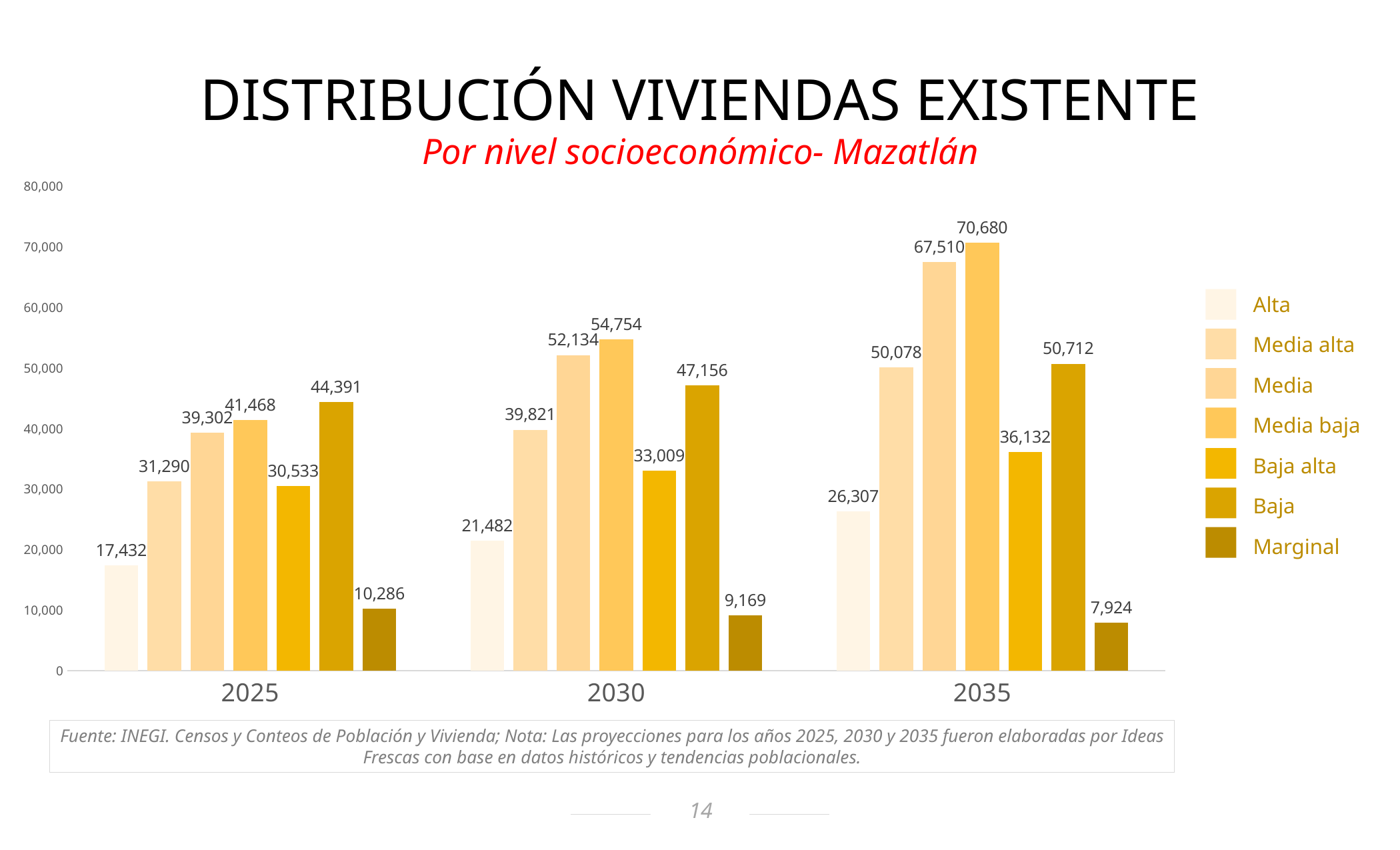
What is the value for Baja alta in 2030? 33,009 Which series has the lowest value in 2035? Marginal Which series has the highest value in 2025? Baja What is the difference between the Media baja and Media values in 2030? 2,620 What kind of chart is shown on the slide? Bar chart What is the value for Alta in 2025? 17,432 Which is larger in 2035: Baja or Media alta? Baja How many series does the legend list? 7 What is the value for Media baja in 2035? 70,680 How many year categories are shown on the x axis? 3 Is the value for Media in 2030 greater or less than 50,000? greater Do the Marginal values rise or fall from 2025 to 2035? Fall